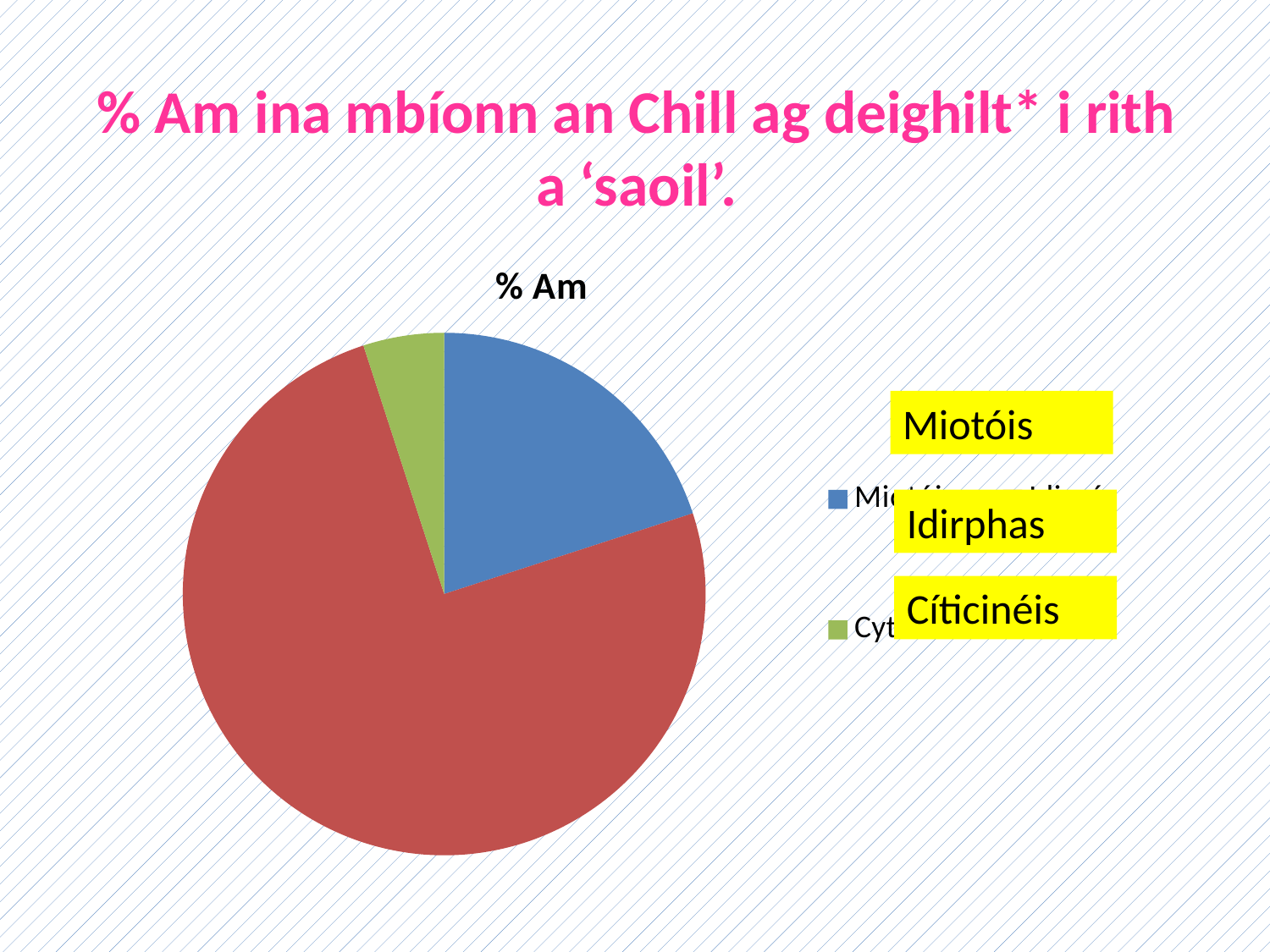
What kind of chart is shown on the slide? pie chart Which slice is smaller, Idirphas or Cíticinéis? Cíticinéis How many slices does the pie chart have? 3 Which slice is larger, Miotóis or Cíticinéis? Miotóis Which slice is larger, Miotóis or Idirphas? Idirphas What colour is the Idirphas slice of the pie chart? red Which category has the largest slice of the pie chart? Idirphas What is the title of the pie chart? % Am Which category has the smallest slice of the pie chart? Cíticinéis